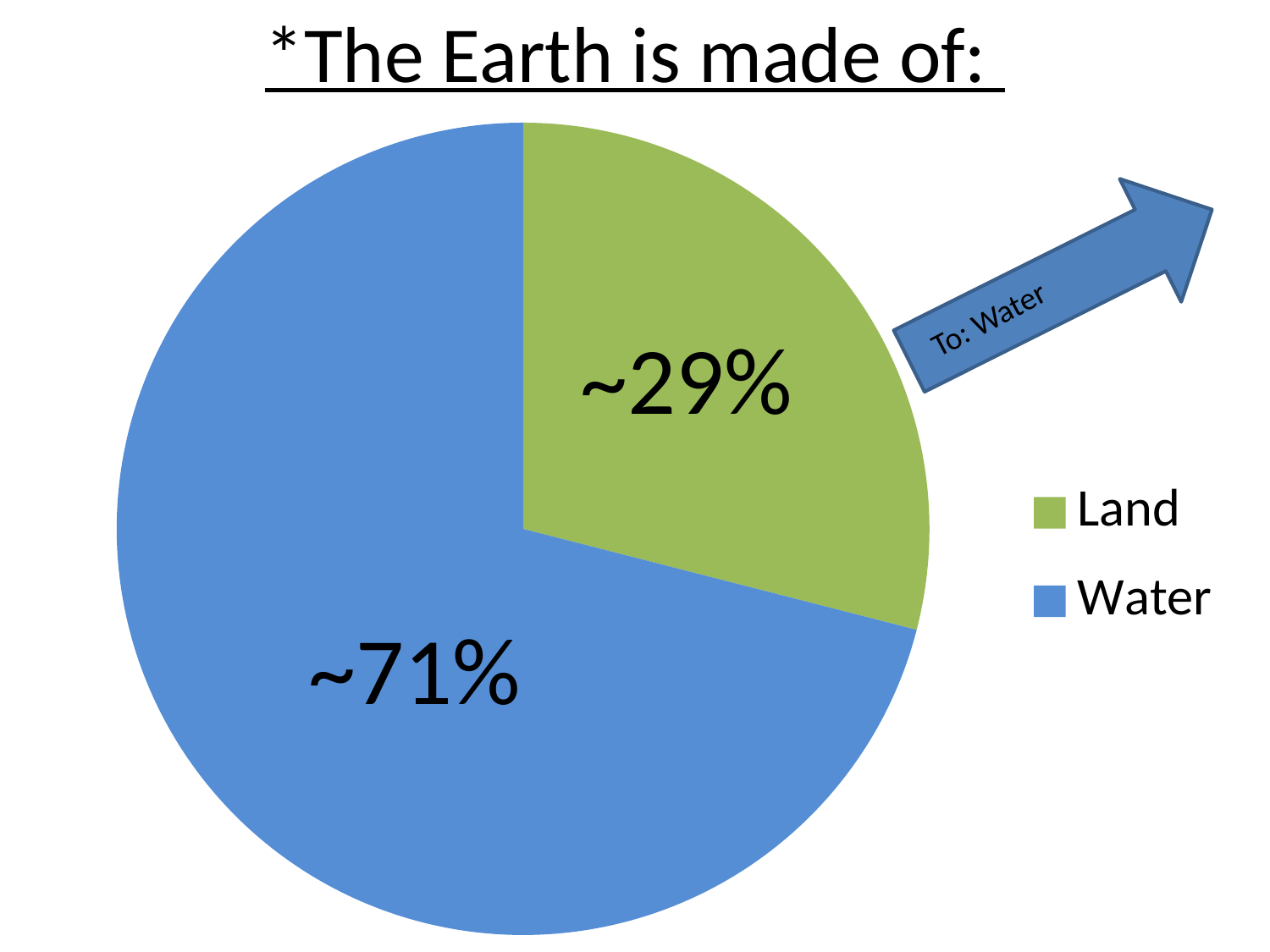
Which slice is the largest? Water How many slices does the pie chart have? 2 What kind of chart is shown on the slide? pie chart What colour is the Land slice? green Which is larger, the Land slice or the Water slice? Water What share of the pie does the Water slice represent? ~71% What value is labelled on the Water slice? ~71% How many entries does the legend list? 2 What share of the pie does the Land slice represent? ~29% What is the title of the chart? *The Earth is made of: Which slice is the smallest? Land What value is labelled on the Land slice? ~29%